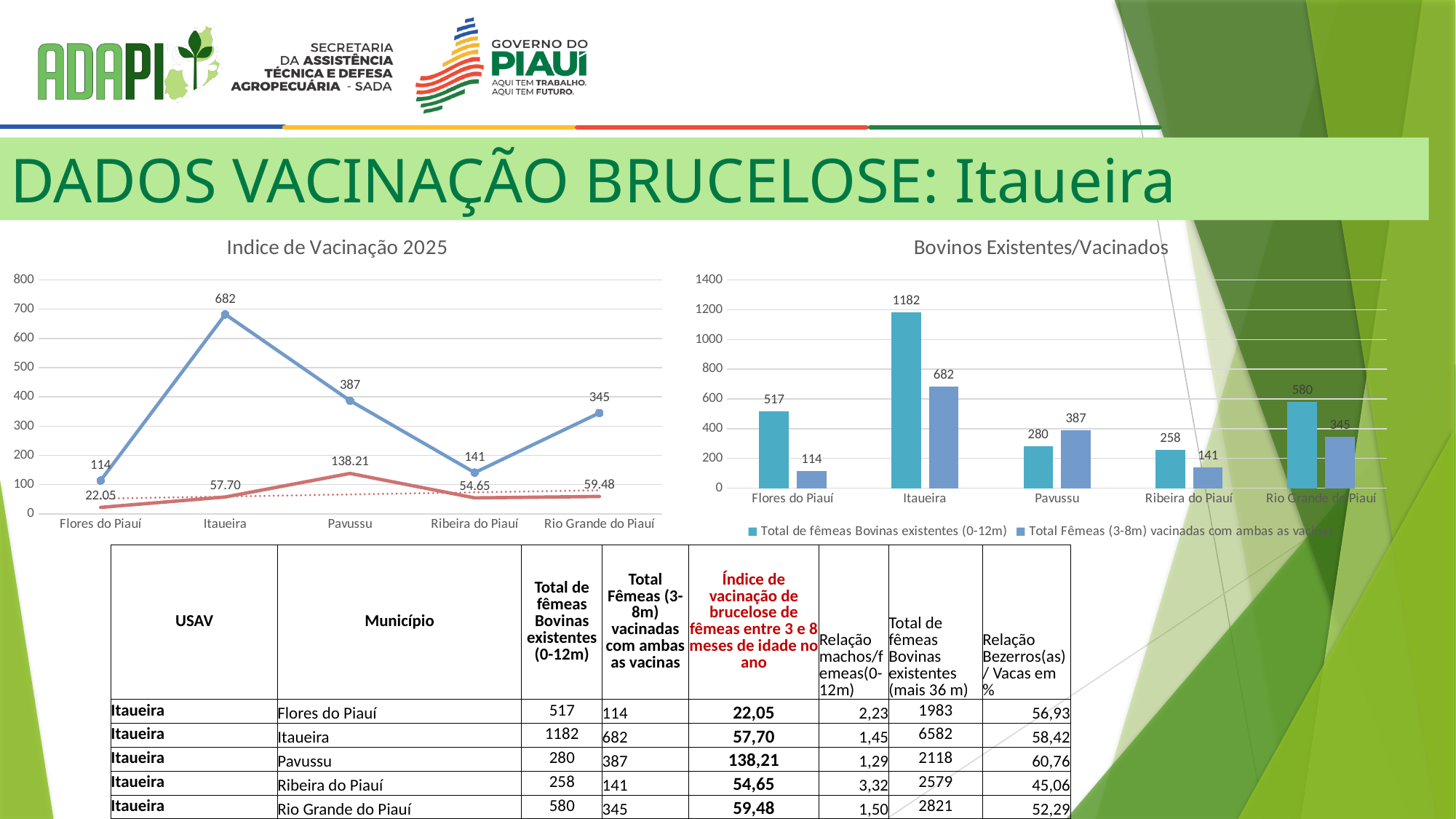
In the 'Bovinos Existentes/Vacinados' chart, which municipality has the highest value for 'Total Fêmeas (3-8m) vacinadas com ambas as vacinas'? Itaueira How many series does the legend of the 'Bovinos Existentes/Vacinados' chart list? 2 In the 'Bovinos Existentes/Vacinados' chart, what is the value of 'Total de fêmeas Bovinas existentes (0-12m)' for Itaueira? 1182 How many municipalities are shown on the x axis of the 'Indice de Vacinação 2025' chart? 5 In the 'Indice de Vacinação 2025' chart, at which municipality does the blue line reach its highest value? Itaueira In the 'Bovinos Existentes/Vacinados' chart, what is the difference between the existing females (0-12m) and the vaccinated females (3-8m) for Flores do Piauí? 403 In the 'Indice de Vacinação 2025' chart, what is the value of the red line for Pavussu? 138.21 In the 'Bovinos Existentes/Vacinados' chart, is the value of existing females (0-12m) for Rio Grande do Piauí greater or less than 400? greater In the 'Bovinos Existentes/Vacinados' chart, for Pavussu, which is larger: the existing females (0-12m) or the vaccinated females (3-8m)? Vaccinated females (3-8m) What kind of chart is 'Indice de Vacinação 2025'? Line chart What kind of chart is 'Bovinos Existentes/Vacinados'? Bar chart In the 'Indice de Vacinação 2025' chart, does the blue line rise or fall from Itaueira to Ribeira do Piauí? Fall